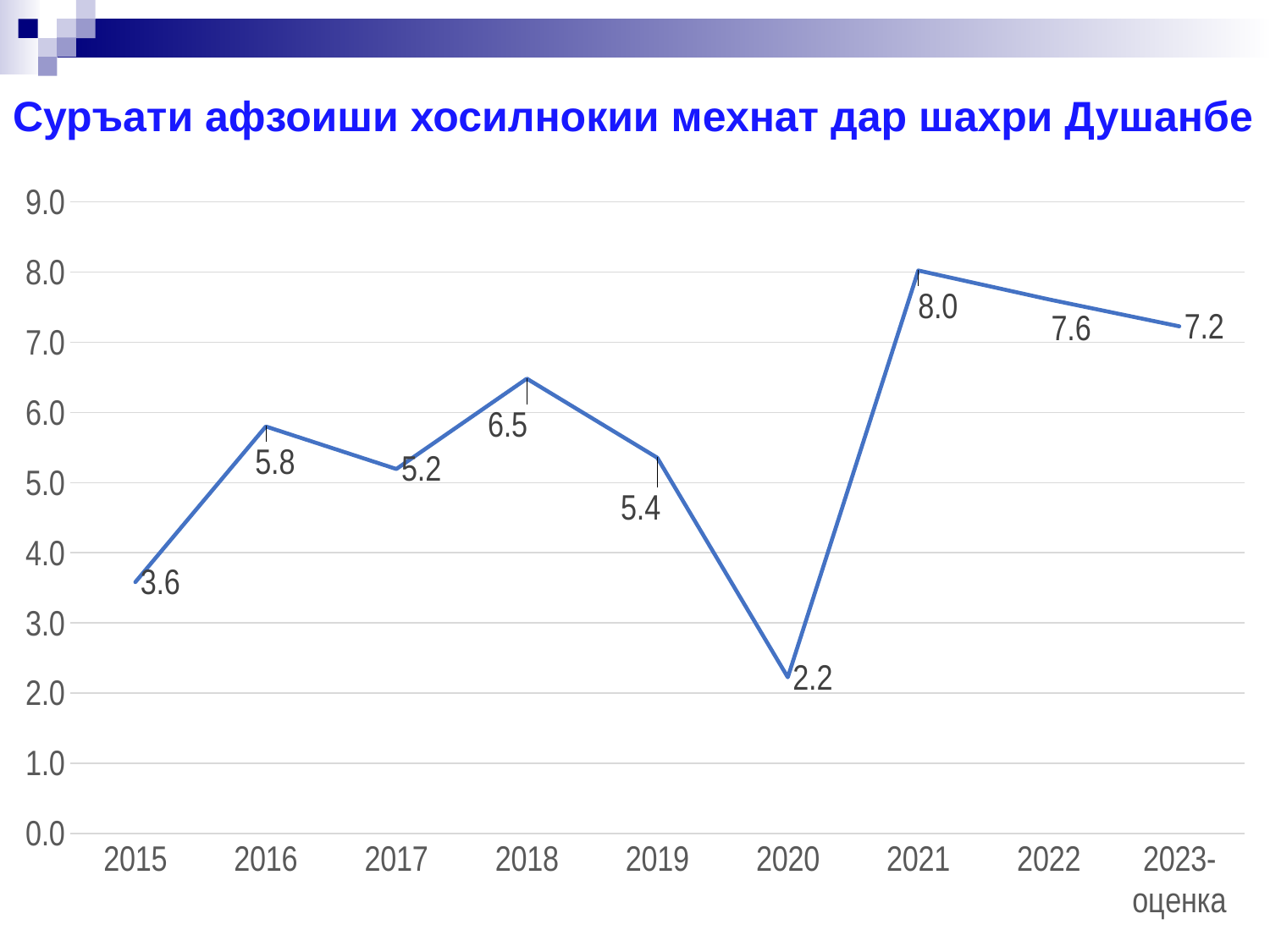
Is the value for 2022 greater or less than 7.0? greater Which is larger, the value for 2018 or the value for 2019? 2018 How many years are plotted on the x axis? 9 What is the difference between the values for 2021 and 2020? 5.8 Which year has the lowest value? 2020 What kind of chart is shown? line chart What is the value for 2023-оценка? 7.2 Which year has the highest value? 2021 What is the value for 2020? 2.2 Do the values rise or fall from 2021 to 2023-оценка? fall What is the value for 2015? 3.6 What is the title of the chart? Суръати афзоиши хосилнокии мехнат дар шахри Душанбе